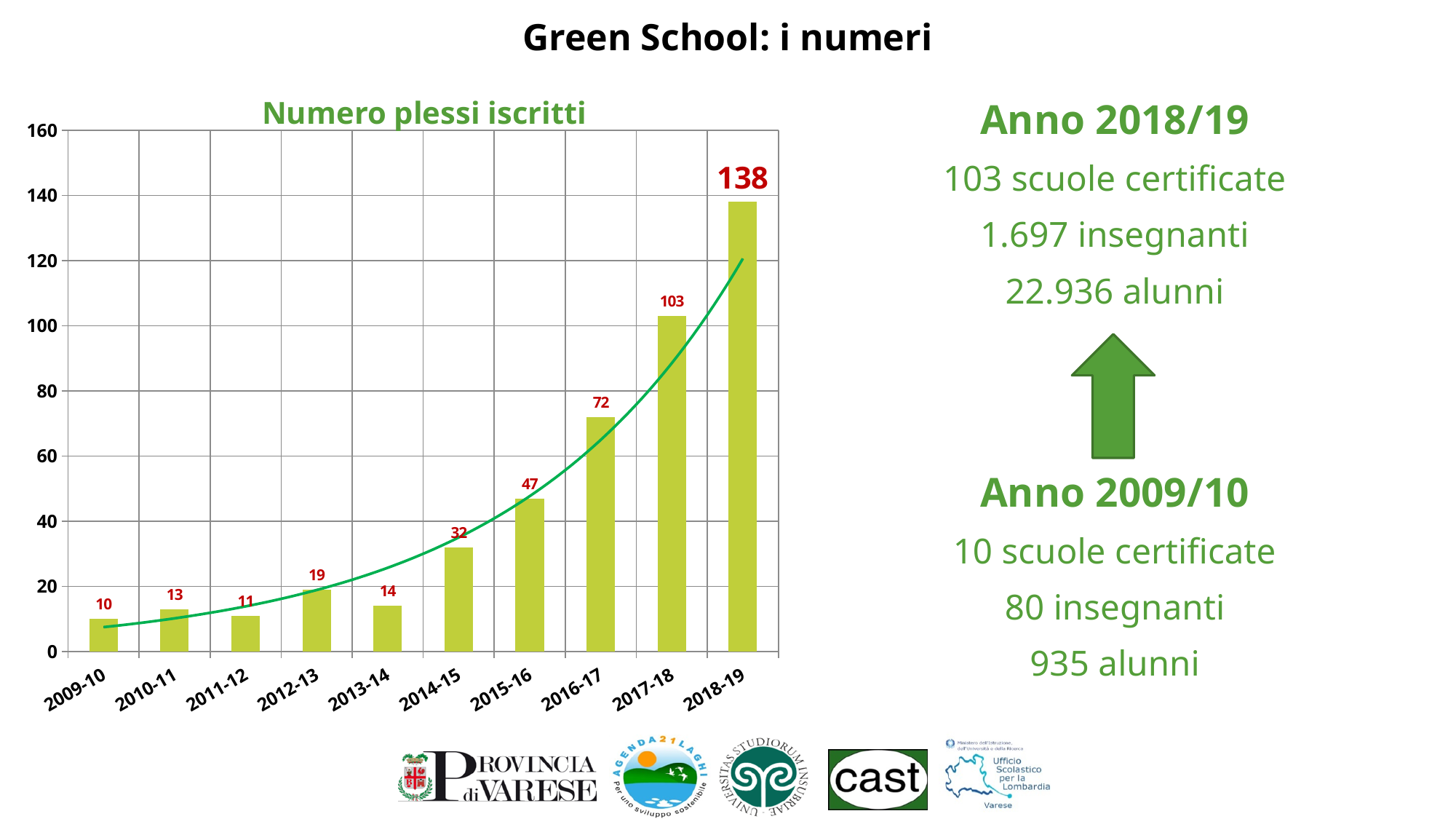
What is the value for 2015-16 in the chart? 47 Which year has the lowest number of plessi iscritti? 2009-10 What kind of chart is shown on the slide? bar chart Is the value for 2017-18 greater or less than 100? greater Which is larger, the value for 2012-13 or the value for 2013-14? 2012-13 What is the difference between the values for 2018-19 and 2017-18? 35 How many years are shown on the x axis of the chart? 10 What is the value for 2018-19 in the chart? 138 What is the value for 2013-14 in the chart? 14 What is the title of the chart? Numero plessi iscritti What is the difference between the values for 2016-17 and 2015-16? 25 Which year has the highest number of plessi iscritti? 2018-19